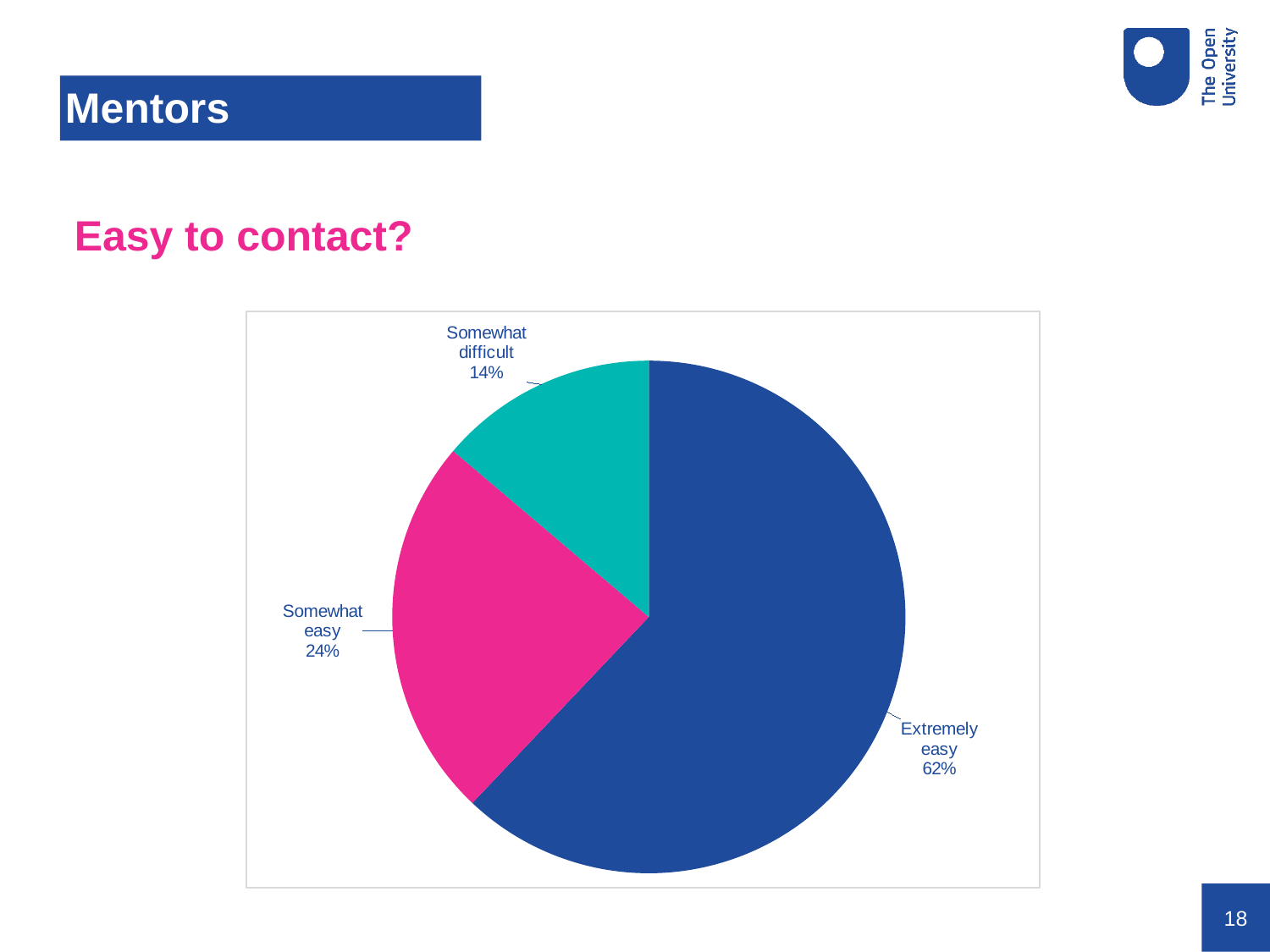
What percentage of respondents said their mentor was extremely easy to contact? 62% What is the combined share of 'Extremely easy' and 'Somewhat easy'? 86% Which category has the largest share of the pie? Extremely easy What is the difference in percentage points between 'Somewhat easy' and 'Somewhat difficult'? 10 What percentage is shown for the 'Somewhat easy' slice? 24% What percentage is shown for the 'Somewhat difficult' slice? 14% What is the difference in percentage points between 'Extremely easy' and 'Somewhat easy'? 38 What kind of chart is shown on the slide? pie chart How many slices does the pie chart have? 3 Which category has the smallest share of the pie? Somewhat difficult What colour is the 'Somewhat difficult' slice? teal Which is larger, the 'Somewhat easy' slice or the 'Somewhat difficult' slice? Somewhat easy